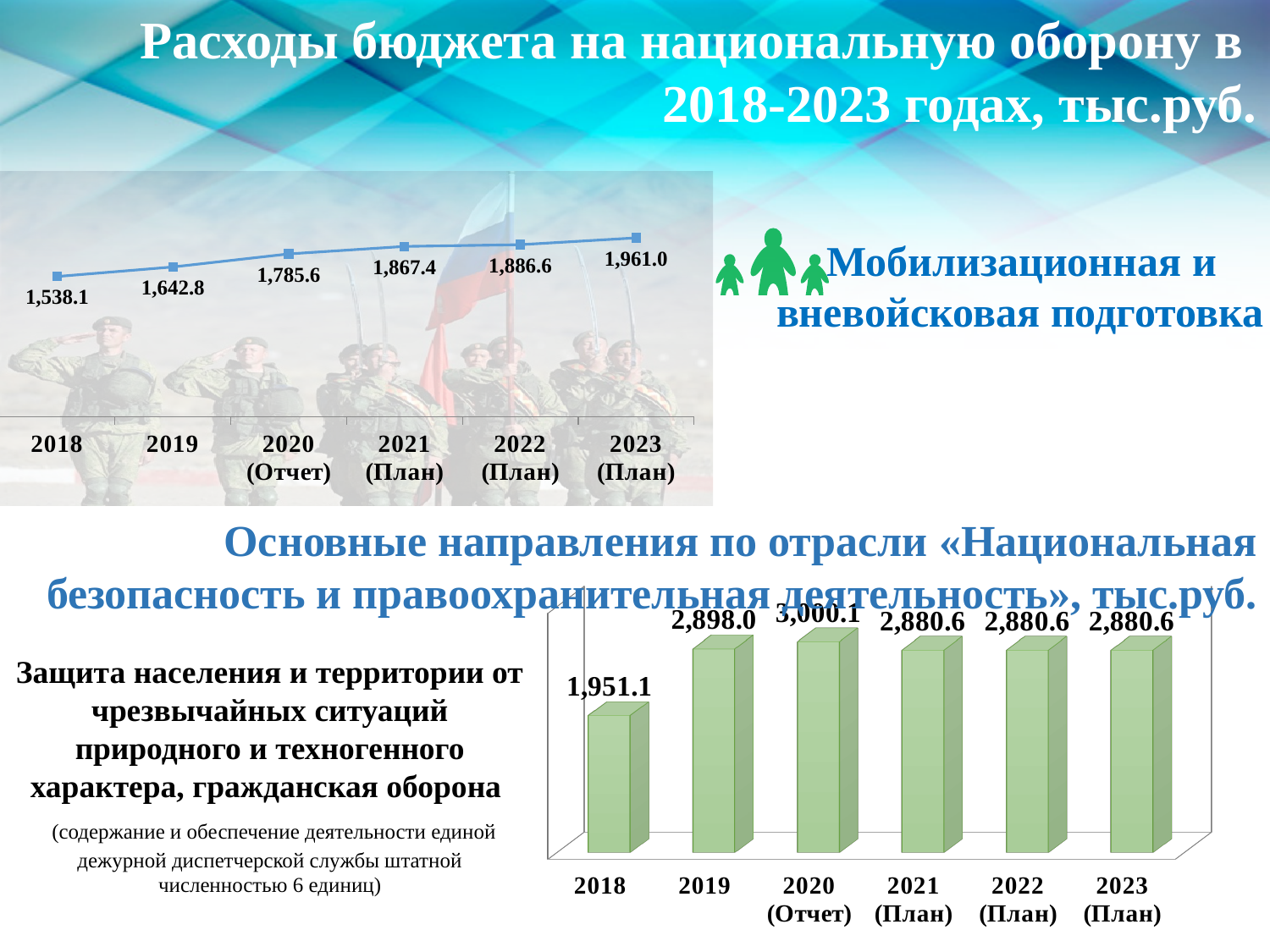
On the top chart (Расходы бюджета на национальную оборону), what is the difference between the 2023 (План) and 2018 values? 422.9 How many years are plotted on the top chart (Расходы бюджета на национальную оборону)? 6 On the bottom chart (Защита населения и территории от чрезвычайных ситуаций), what is the difference between the 2019 and 2018 values? 946.9 On the bottom chart (Защита населения и территории от чрезвычайных ситуаций), which is larger, the value for 2020 (Отчет) or 2021 (План)? 2020 (Отчет) What kind of chart is the bottom chart (Защита населения и территории от чрезвычайных ситуаций)? bar chart On the top chart (Расходы бюджета на национальную оборону), do the values rise or fall from 2018 to 2023? rise On the top chart (Расходы бюджета на национальную оборону), what is the value for 2018? 1,538.1 On the bottom chart (Защита населения и территории от чрезвычайных ситуаций), what is the value for 2018? 1,951.1 On the top chart (Расходы бюджета на национальную оборону), what is the value for 2023 (План)? 1,961.0 On the top chart (Расходы бюджета на национальную оборону), which year has the lowest value? 2018 What kind of chart is the top chart (Расходы бюджета на национальную оборону)? line chart On the bottom chart (Защита населения и территории от чрезвычайных ситуаций), which year has the highest value? 2020 (Отчет)